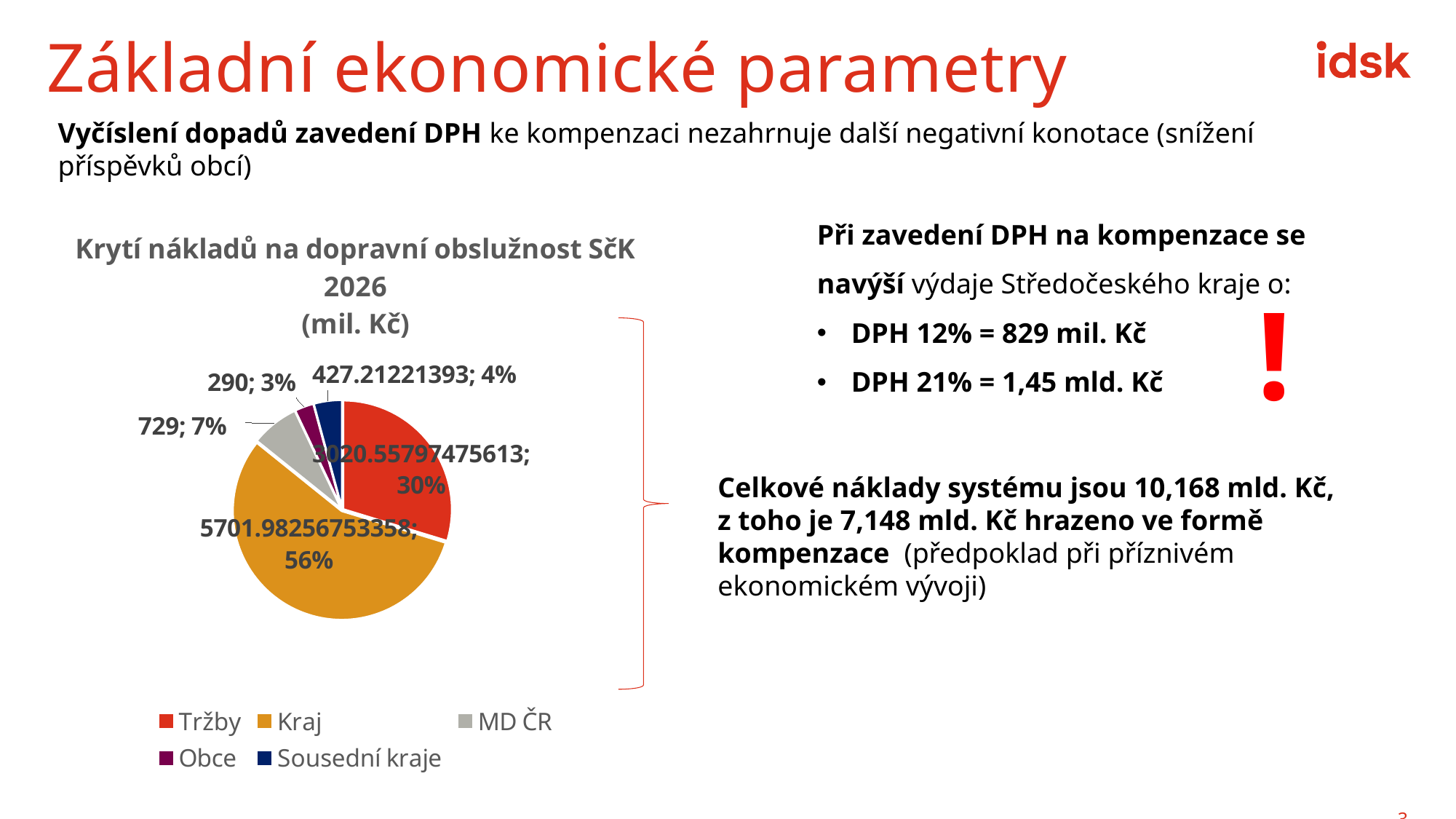
What share of the pie does Kraj represent? 56% Which category has the smallest slice of the pie? Obce What is the value shown for MD ČR in the pie chart? 729 What is the value shown for Obce in the pie chart? 290 How many entries does the legend of the pie chart list? 5 Which is larger in the pie chart, MD ČR or Sousední kraje? MD ČR How many slices does the pie chart have? 5 What is the title of the pie chart? Krytí nákladů na dopravní obslužnost SčK 2026 (mil. Kč) What kind of chart is shown on the slide? pie chart What share of the pie does Tržby represent? 30% What share of the pie does MD ČR represent? 7% Which category has the largest slice of the pie? Kraj